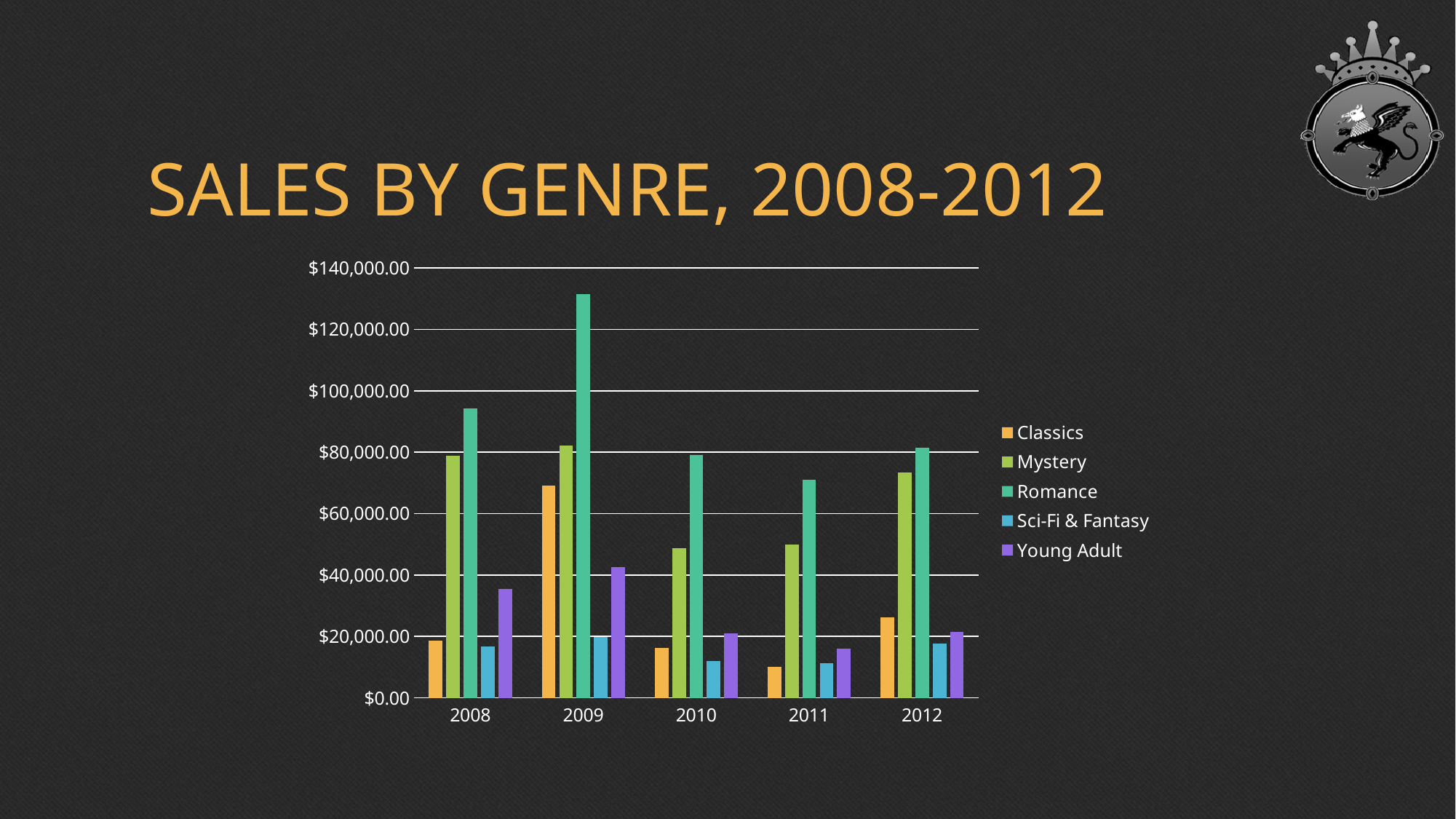
Which genre is shown in purple in the legend? Young Adult In 2008, which is larger: Mystery or Romance sales? Romance Is the value for Romance in 2009 greater or less than $120,000.00? greater In which year are Classics sales lowest? 2011 In which year are Romance sales highest? 2009 What kind of chart is shown on the slide? bar chart What is the title of the chart? SALES BY GENRE, 2008-2012 How many years are shown on the x axis? 5 Which genre has the highest sales in 2011? Romance How many series does the legend list? 5 Is the value for Classics in 2009 greater or less than $60,000.00? greater Is the value for Mystery in 2010 greater or less than $60,000.00? less